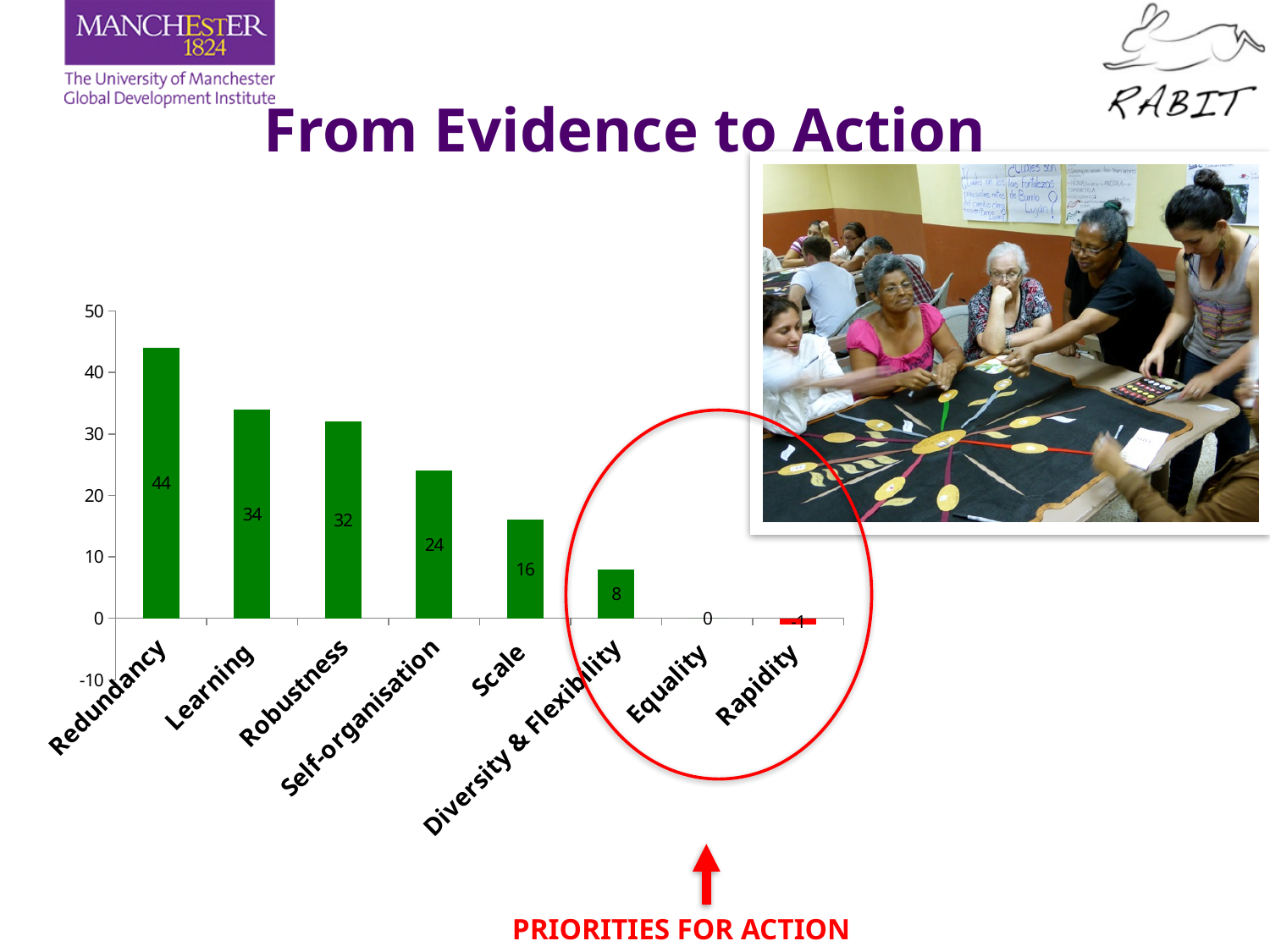
What is the value for Diversity & Flexibility? 8 What is the difference between the values for Learning and Robustness? 2 Which category has the lowest value? Rapidity What is the difference between the values for Redundancy and Scale? 28 What is the value for Redundancy? 44 Which category has the highest value? Redundancy What is the value for Equality? 0 What is the value for Self-organisation? 24 Which is larger, the value for Learning or the value for Self-organisation? Learning What kind of chart is shown on the slide? Bar chart How many categories are shown on the x axis? 8 Do the values rise or fall moving from left to right along the x axis? Fall